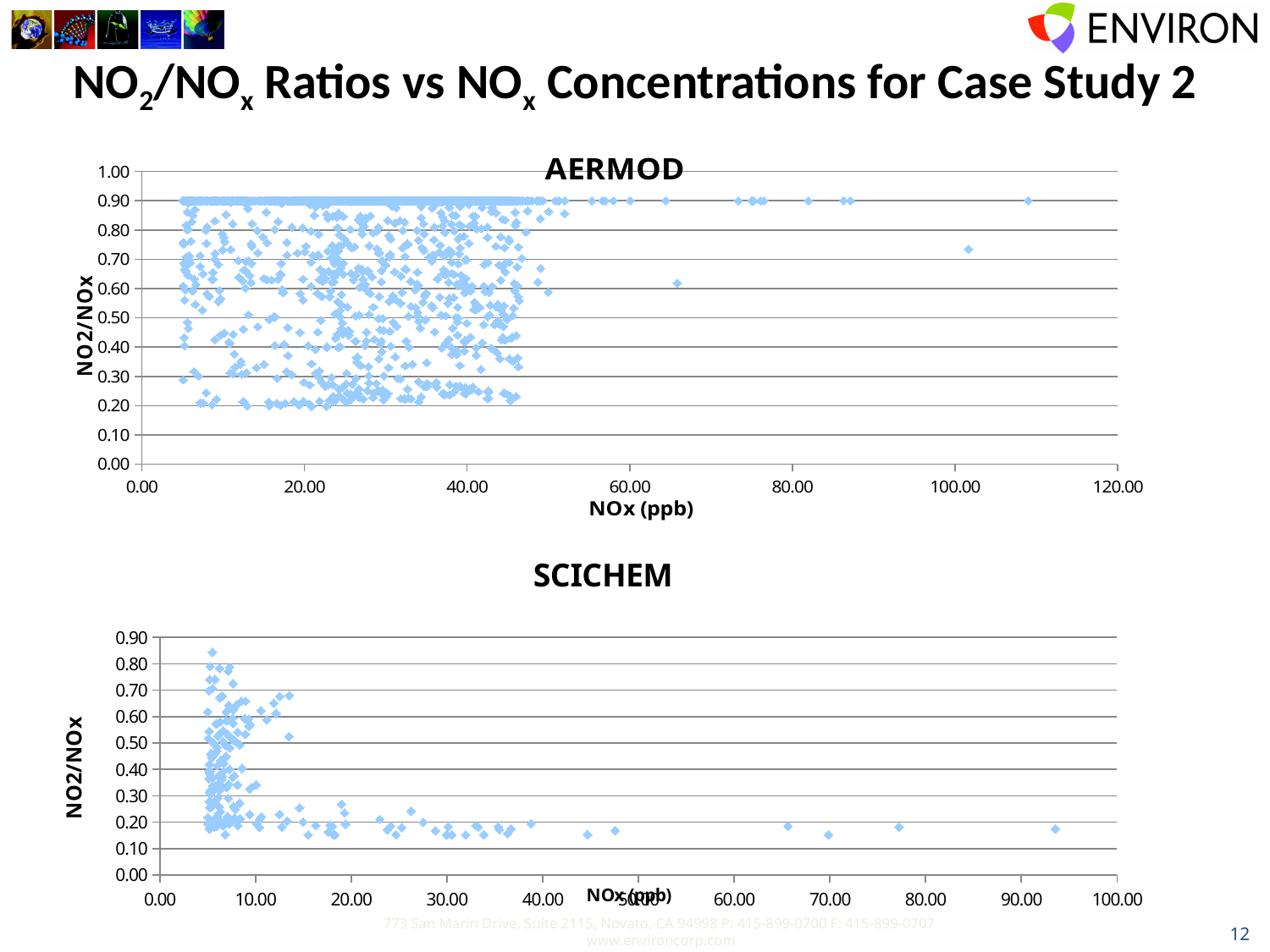
In the SCICHEM chart, do the NO2/NOx ratios generally rise or fall as NOx concentration increases? fall In the AERMOD chart, is the highest NO2/NOx ratio plotted greater or less than 1.00? less In the AERMOD chart, is the lowest NO2/NOx ratio plotted greater or less than 0.10? greater In the SCICHEM chart, is the highest NO2/NOx ratio plotted greater or less than 0.70? greater What kind of chart is the AERMOD chart? scatter chart How many charts are shown on the slide? 2 What is the x-axis title of the AERMOD chart? NOx (ppb) What is the y-axis title of the SCICHEM chart? NO2/NOx What kind of chart is the SCICHEM chart? scatter chart